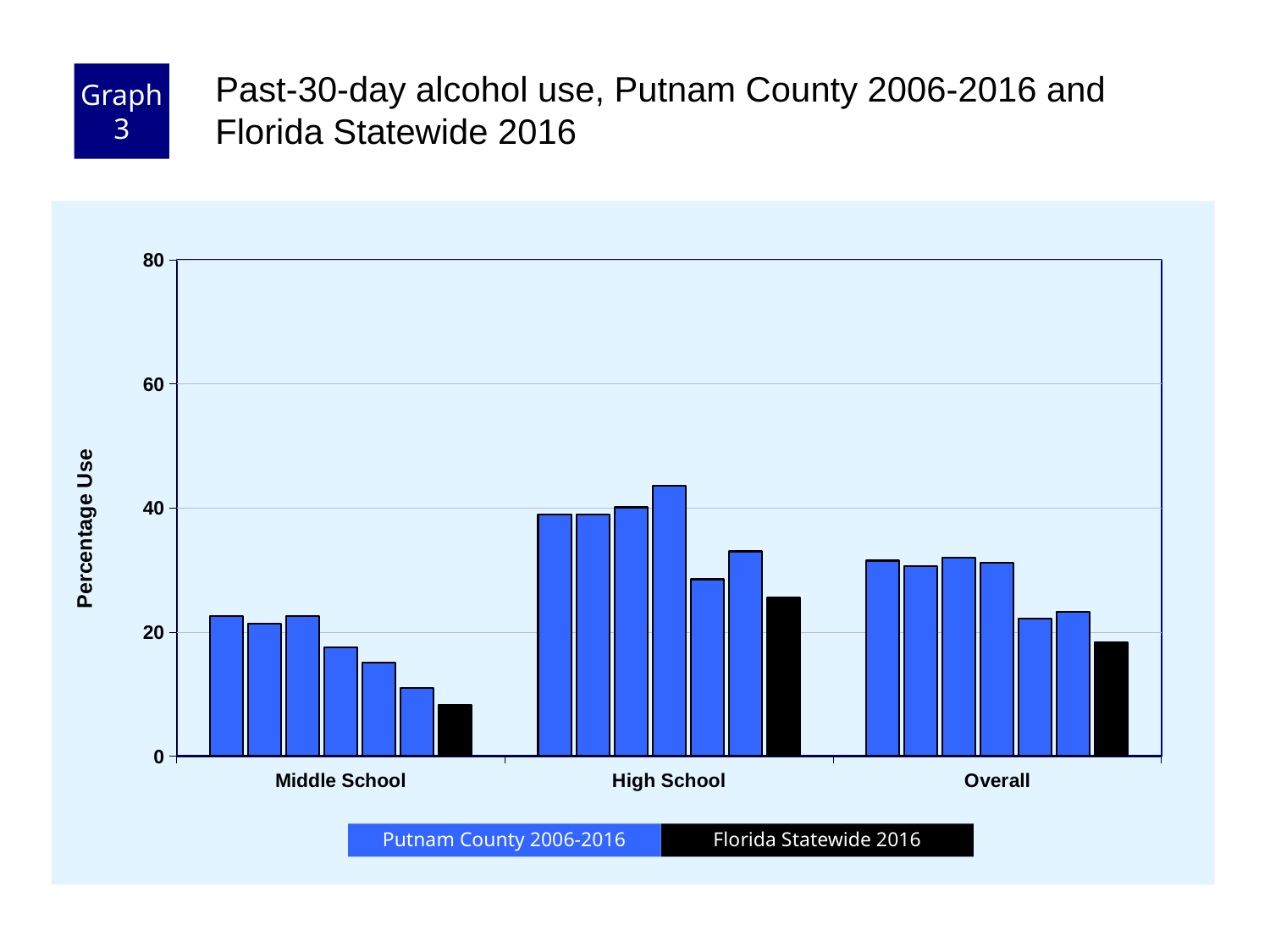
Is the Florida Statewide 2016 value for Middle School greater or less than 20? less Which category has the lowest Florida Statewide 2016 value? Middle School Do the Putnam County 2006-2016 bars for Middle School generally rise or fall from left to right? fall What kind of chart is shown on the slide? bar chart How many categories are shown on the x axis? 3 Is the Florida Statewide 2016 value for High School greater or less than 20? greater What is the title of the y axis? Percentage Use Is the Florida Statewide 2016 value for Overall greater or less than 20? less How many series does the legend list? 2 Which is larger, the Florida Statewide 2016 value for Middle School or for Overall? Overall Which category has the highest Florida Statewide 2016 value? High School